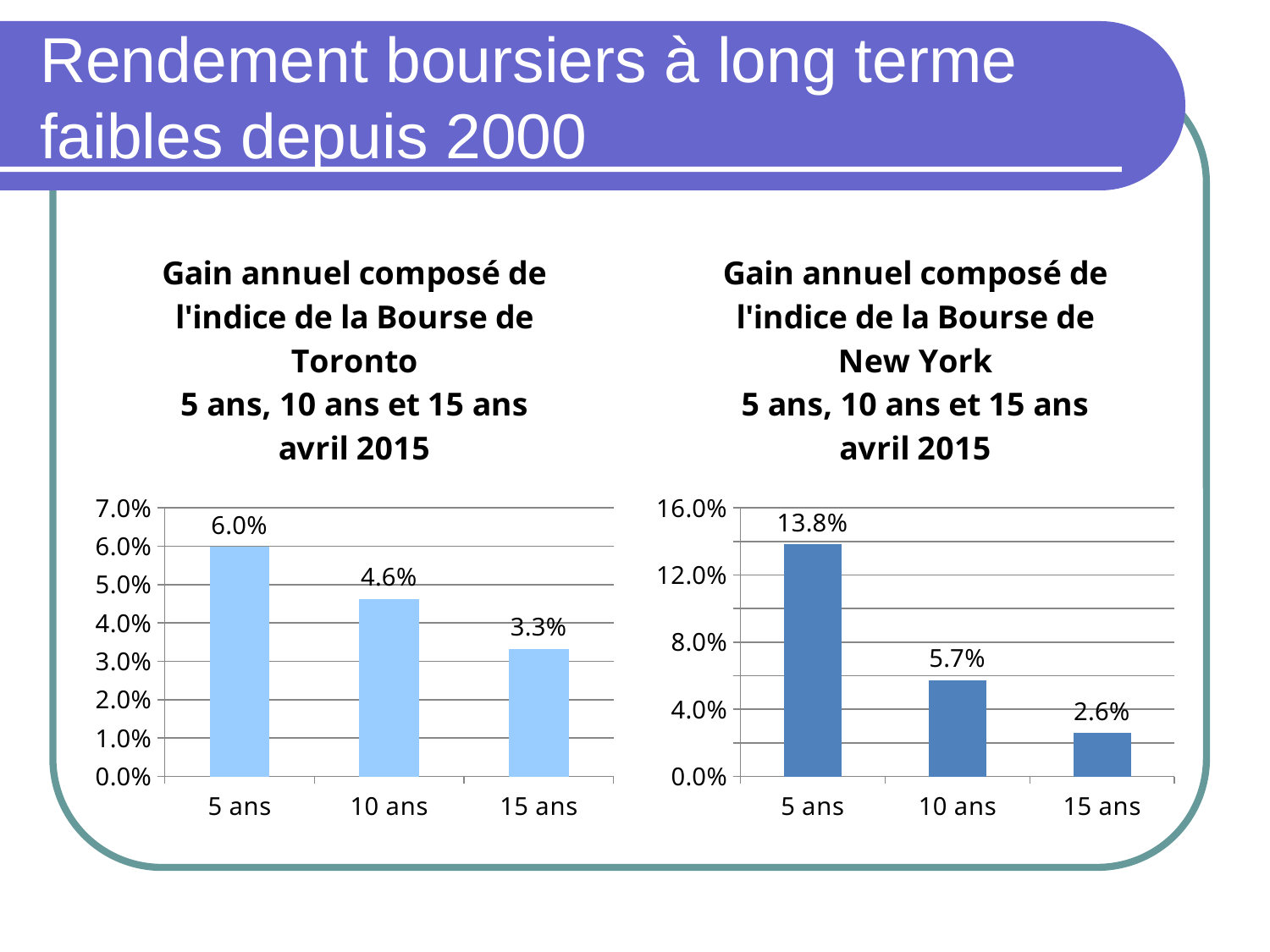
In the Toronto chart (left), what is the value for 15 ans? 3.3% How many categories are shown in the Toronto chart (left)? 3 In the Toronto chart (left), which period has the lowest value? 15 ans In the New York chart (right), what is the value for 15 ans? 2.6% In the New York chart (right), what is the value for 10 ans? 5.7% In the New York chart (right), what is the difference between the 5 ans and 15 ans values? 11.2% In the New York chart (right), do the values rise or fall from 5 ans to 15 ans? Fall In the Toronto chart (left), what is the difference between the 5 ans and 10 ans values? 1.4% In the New York chart (right), which period has the highest value? 5 ans What kind of chart is the New York chart (right)? Bar chart In the Toronto chart (left), what is the value for 5 ans? 6.0% Which is larger: the 10 ans value in the Toronto chart or the 10 ans value in the New York chart? New York